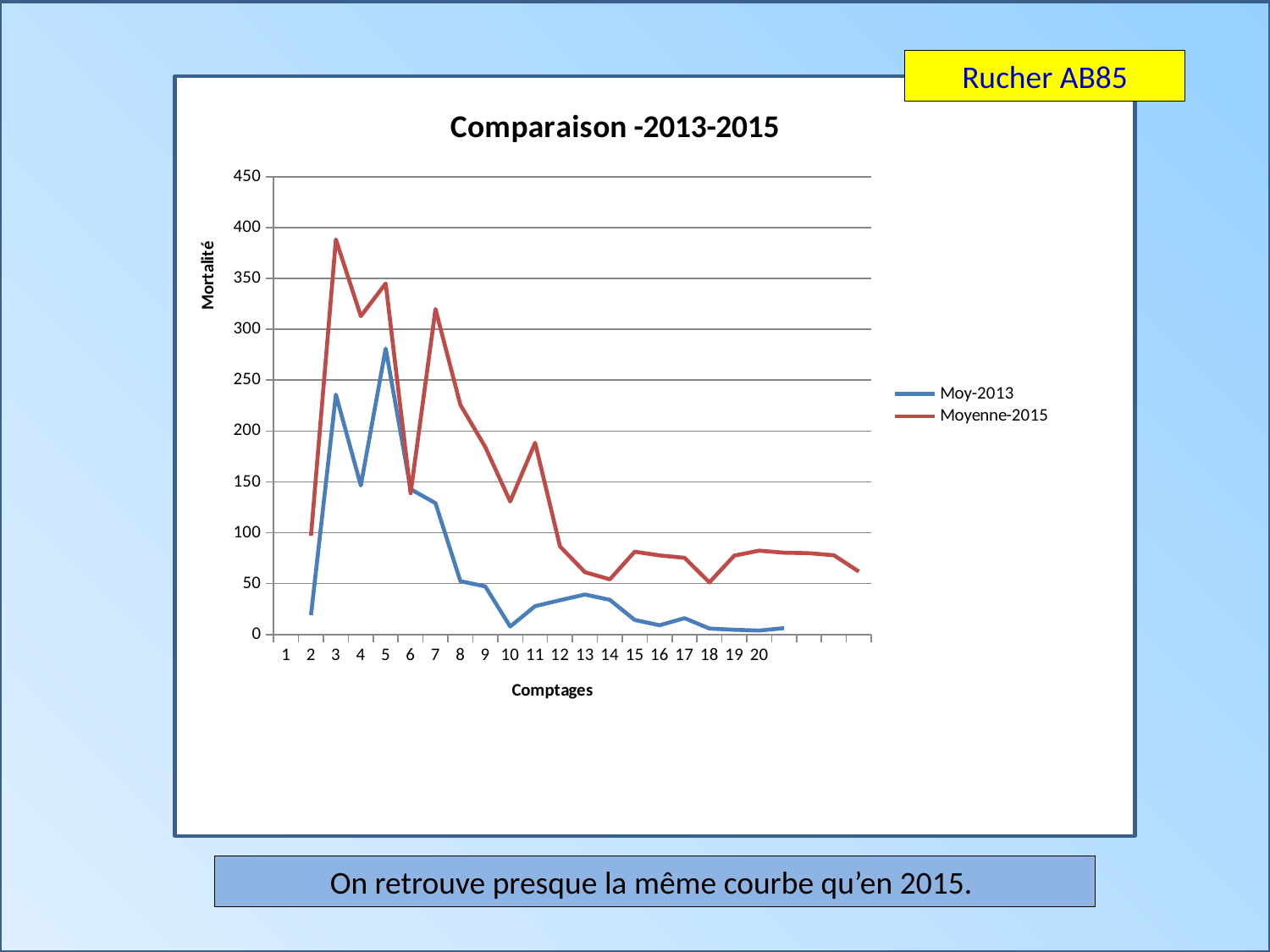
How many series does the legend list? 2 Does the Moy-2013 series rise or fall between comptage 5 and comptage 10? fall Is the value for Moyenne-2015 at comptage 3 greater or less than 350? greater At which comptage does the Moyenne-2015 series reach its highest value? 3 Is the value for Moy-2013 at comptage 5 greater or less than 250? greater Is the value for Moyenne-2015 at comptage 11 greater or less than 150? greater What kind of chart is shown on the slide? line chart What are the two series named in the legend? Moy-2013 and Moyenne-2015 At which comptage does the Moy-2013 series reach its highest value? 5 What is the title of the chart? Comparaison -2013-2015 At comptage 7, which series has the higher value, Moy-2013 or Moyenne-2015? Moyenne-2015